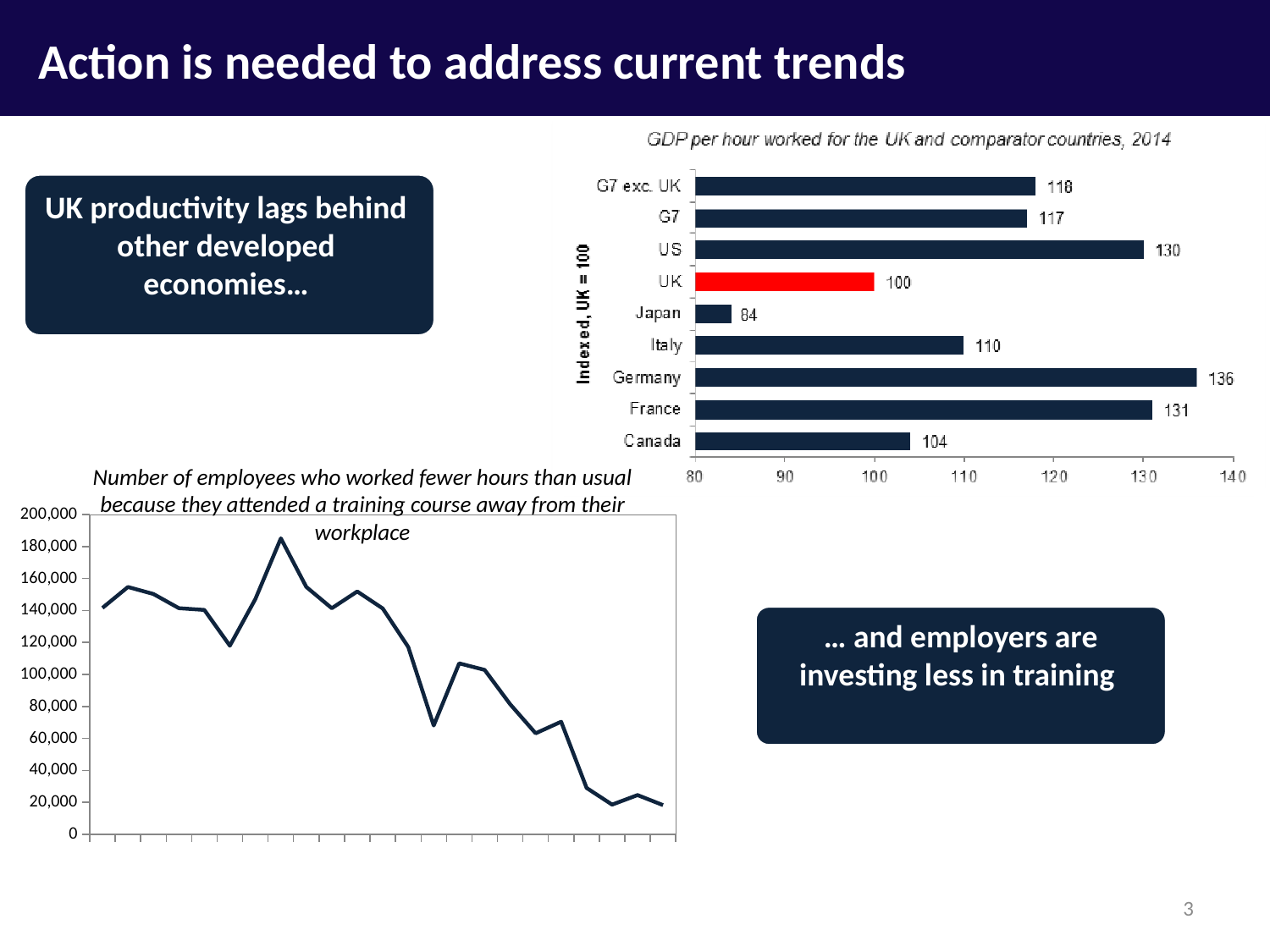
In the chart titled 'GDP per hour worked for the UK and comparator countries, 2014', what is the value for Germany? 136 In the chart titled 'GDP per hour worked for the UK and comparator countries, 2014', what is the value for G7 exc. UK? 118 In the chart titled 'GDP per hour worked for the UK and comparator countries, 2014', how many countries or groups are shown? 9 In the chart titled 'GDP per hour worked for the UK and comparator countries, 2014', which is larger, the value for the US or the value for Italy? US In the line chart at the bottom left about employees who attended a training course away from their workplace, is the highest point greater or less than 160,000? greater In the chart titled 'GDP per hour worked for the UK and comparator countries, 2014', what is the value for Japan? 84 In the line chart at the bottom left about employees who attended a training course away from their workplace, do the values generally rise or fall from left to right? Fall In the chart titled 'GDP per hour worked for the UK and comparator countries, 2014', which country or group has the lowest value? Japan What kind of chart is the chart titled 'GDP per hour worked for the UK and comparator countries, 2014'? Bar chart In the chart titled 'GDP per hour worked for the UK and comparator countries, 2014', which country or group has the highest value? Germany In the chart titled 'GDP per hour worked for the UK and comparator countries, 2014', which bar is coloured red? UK In the chart titled 'GDP per hour worked for the UK and comparator countries, 2014', what is the difference between the values for France and Canada? 27